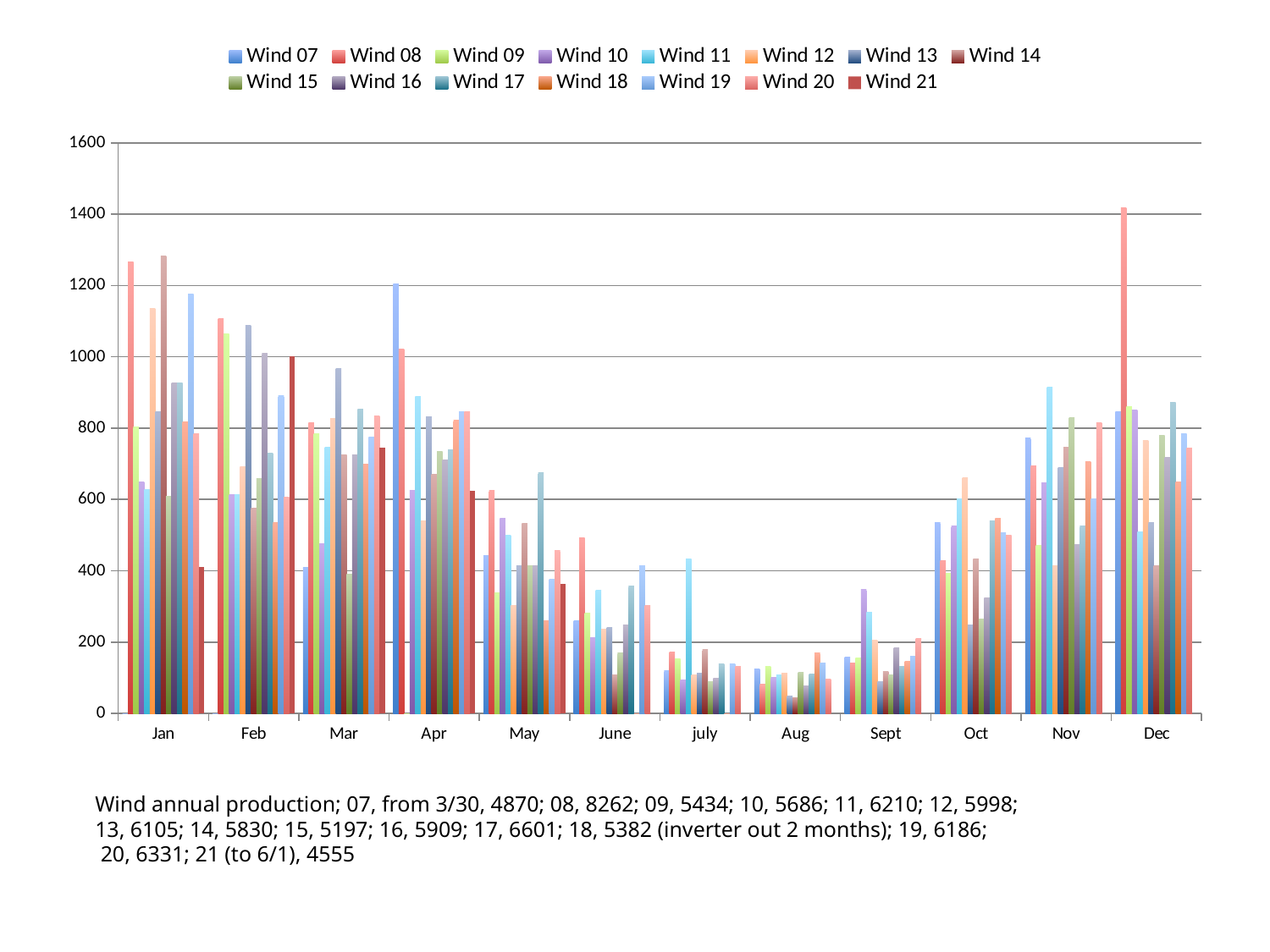
Is the value for Wind 07 in Apr greater or less than 1000? greater How many series does the legend list? 15 Which is larger: Wind 11 in July or Wind 08 in July? Wind 11 in July Which series has the tallest bar in Oct? Wind 12 Is the value for Wind 20 in Dec greater or less than 1200? less Which series has the tallest bar in Nov? Wind 11 What kind of chart is shown on the slide? bar chart In which month does the tallest bar on the chart appear? Dec Do the values generally rise or fall from Jan to Aug? fall How many month categories are shown on the x axis? 12 Is the value for Wind 11 in Nov greater or less than 800? greater